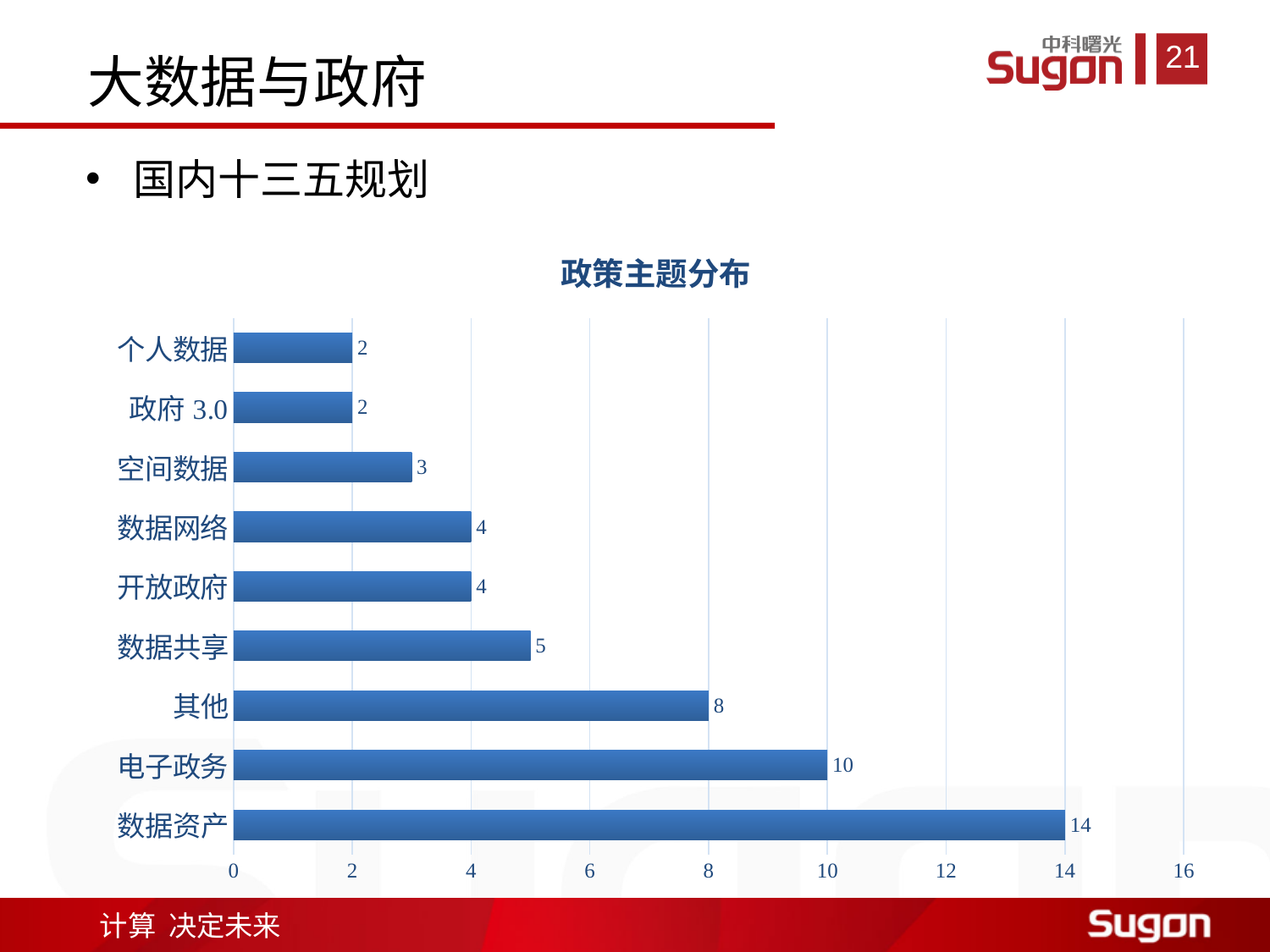
Which is larger, the value for 其他 or the value for 数据共享? 其他 What is the value for 数据资产? 14 Is the value for 电子政务 greater or less than 8? greater Which category has the highest value? 数据资产 What is the value for 空间数据? 3 What is the difference between the values for 其他 and 数据网络? 4 What is the value for 数据共享? 5 What is the title of the chart? 政策主题分布 What is the difference between the values for 数据资产 and 电子政务? 4 What is the value for 电子政务? 10 How many categories are shown in the chart? 9 What kind of chart is shown on the slide? bar chart